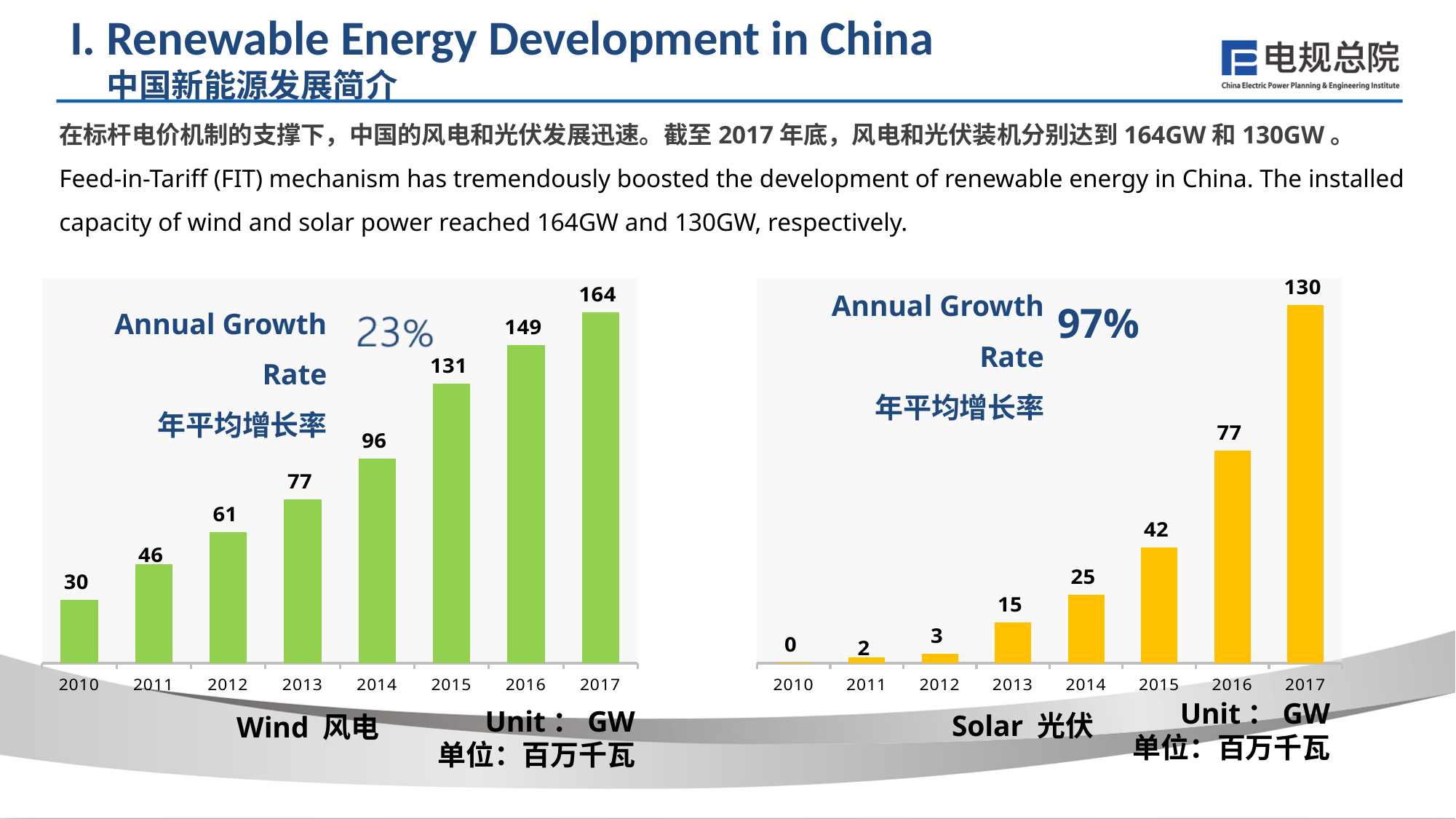
In the Solar chart, what is the value for 2015? 42 In the Wind chart, what is the difference between the values for 2017 and 2016? 15 In the Solar chart, what is the difference between the values for 2017 and 2016? 53 In the Solar chart, which year has the lowest value? 2010 What annual growth rate is shown on the Solar chart? 97% What type of chart is the Solar chart? Bar chart Which is larger: the Wind chart's value for 2013 or the Solar chart's value for 2016? They are equal (77) In the Wind chart, do the values rise or fall from 2010 to 2017? Rise In the Solar chart, is the value for 2014 larger than the value for 2013? Yes In the Wind chart, what is the value for 2014? 96 How many years are shown in the Wind chart? 8 In the Wind chart, which year has the highest value? 2017